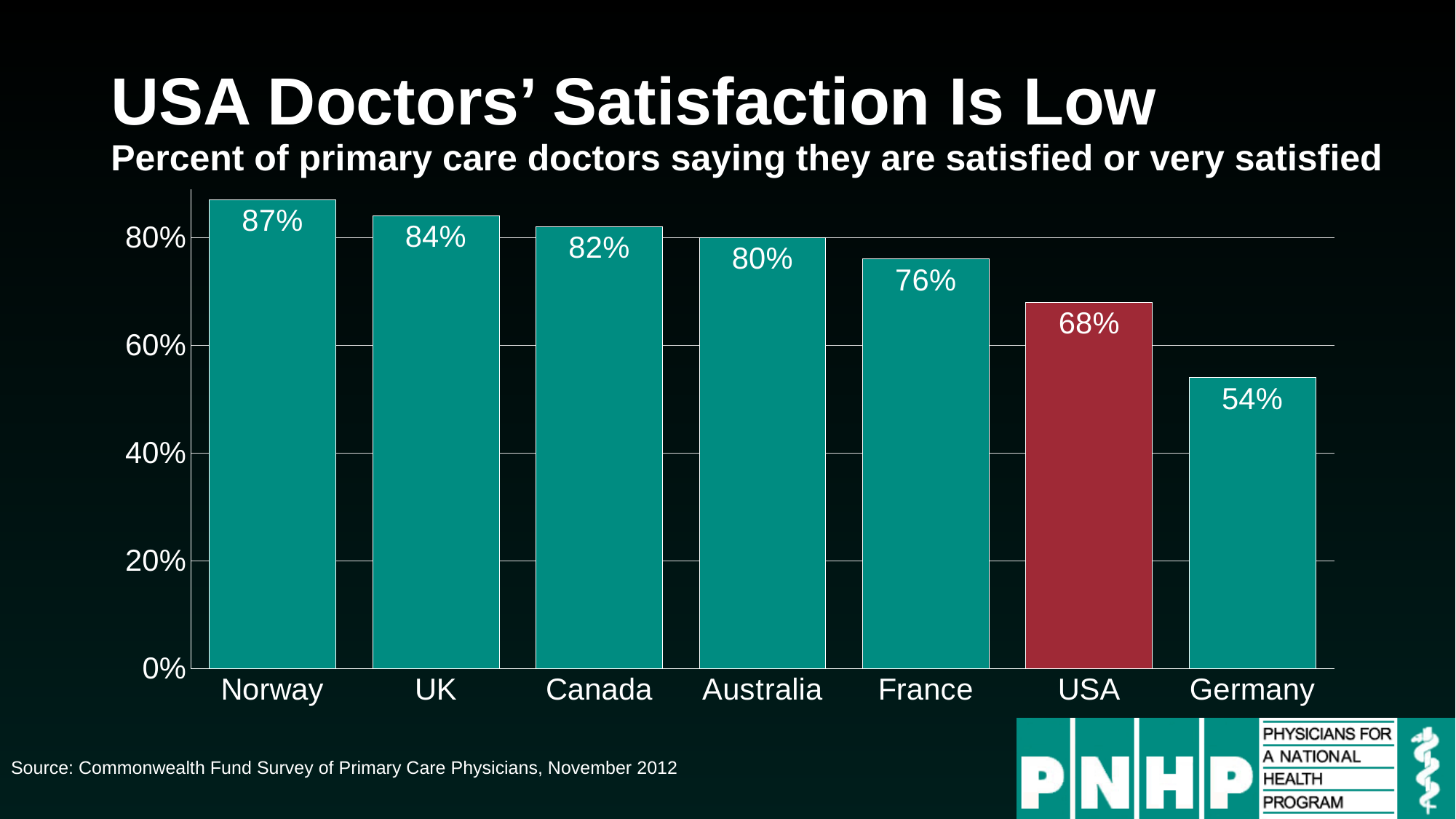
What percentage of primary care doctors in the USA say they are satisfied or very satisfied? 68% Which country's bar is shown in a different colour (red) from the others? USA Which has a higher value, Australia or France? Australia What is the difference in percentage points between the UK and Germany? 30 What is the difference in percentage points between Norway and the USA? 19 Is the value for Germany greater or less than 60%? less What kind of chart is shown on the slide? Bar chart Which country has the highest percentage of satisfied primary care doctors? Norway What is the value shown for France? 76% What is the value shown for Canada? 82% How many countries are shown in the chart? 7 Which country has the lowest percentage of satisfied primary care doctors? Germany